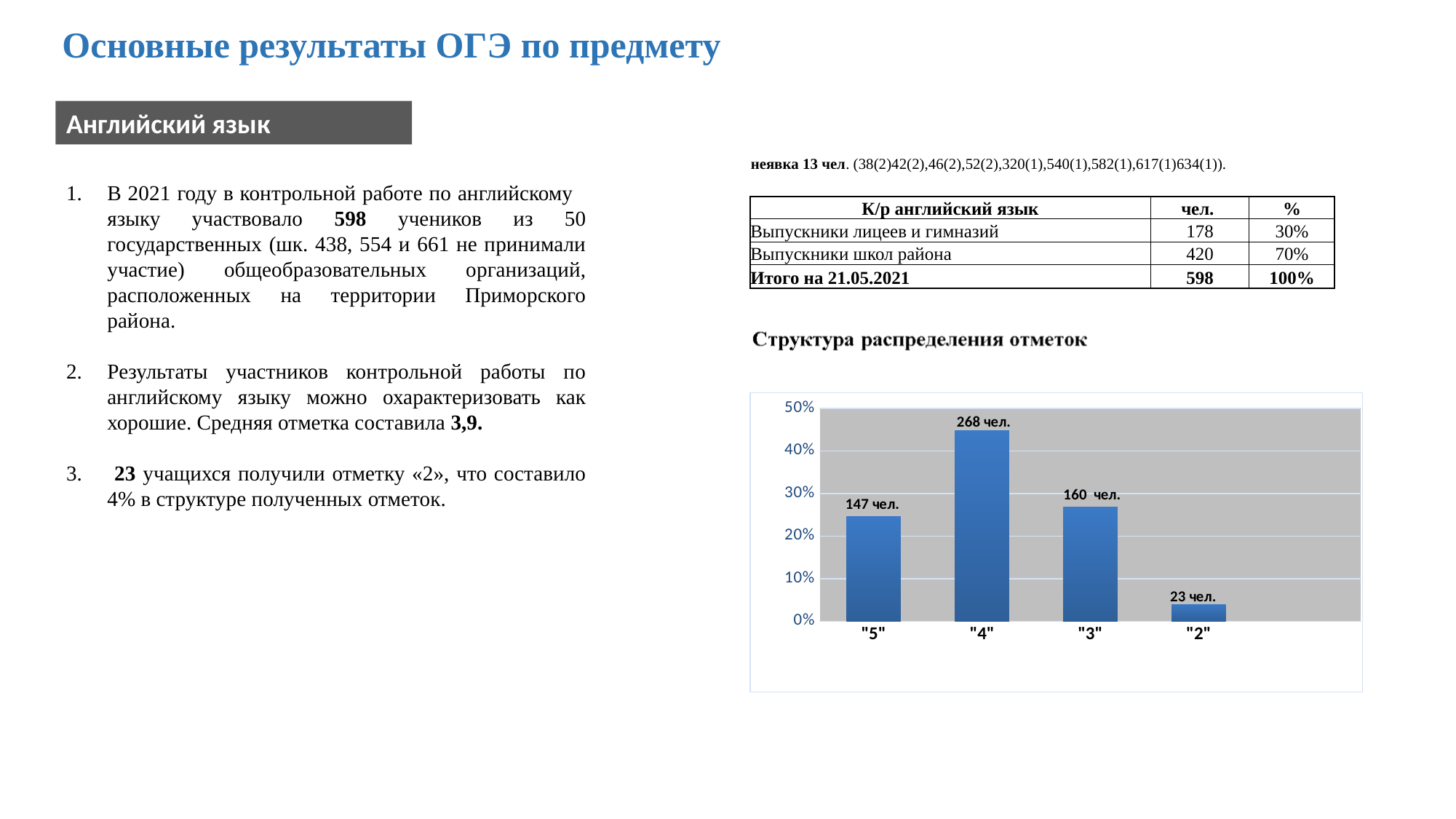
How many grade categories are shown on the x axis of the chart? 4 Is the value for grade "4" greater or less than 40%? greater Is the value for grade "2" greater or less than 10%? less By how many people does the label for grade "4" exceed the label for grade "5"? 121 чел. What type of chart is used to show the distribution of grades? Bar chart What is the title of the chart on the slide? Структура распределения отметок Which grade category has the tallest bar in the chart? "4" What is the data label shown on the bar for grade "4"? 268 чел. What is the data label shown on the bar for grade "2"? 23 чел. Which bar is taller: grade "3" or grade "5"? "3" What is the data label shown on the bar for grade "5"? 147 чел. Which grade category has the shortest bar in the chart? "2"